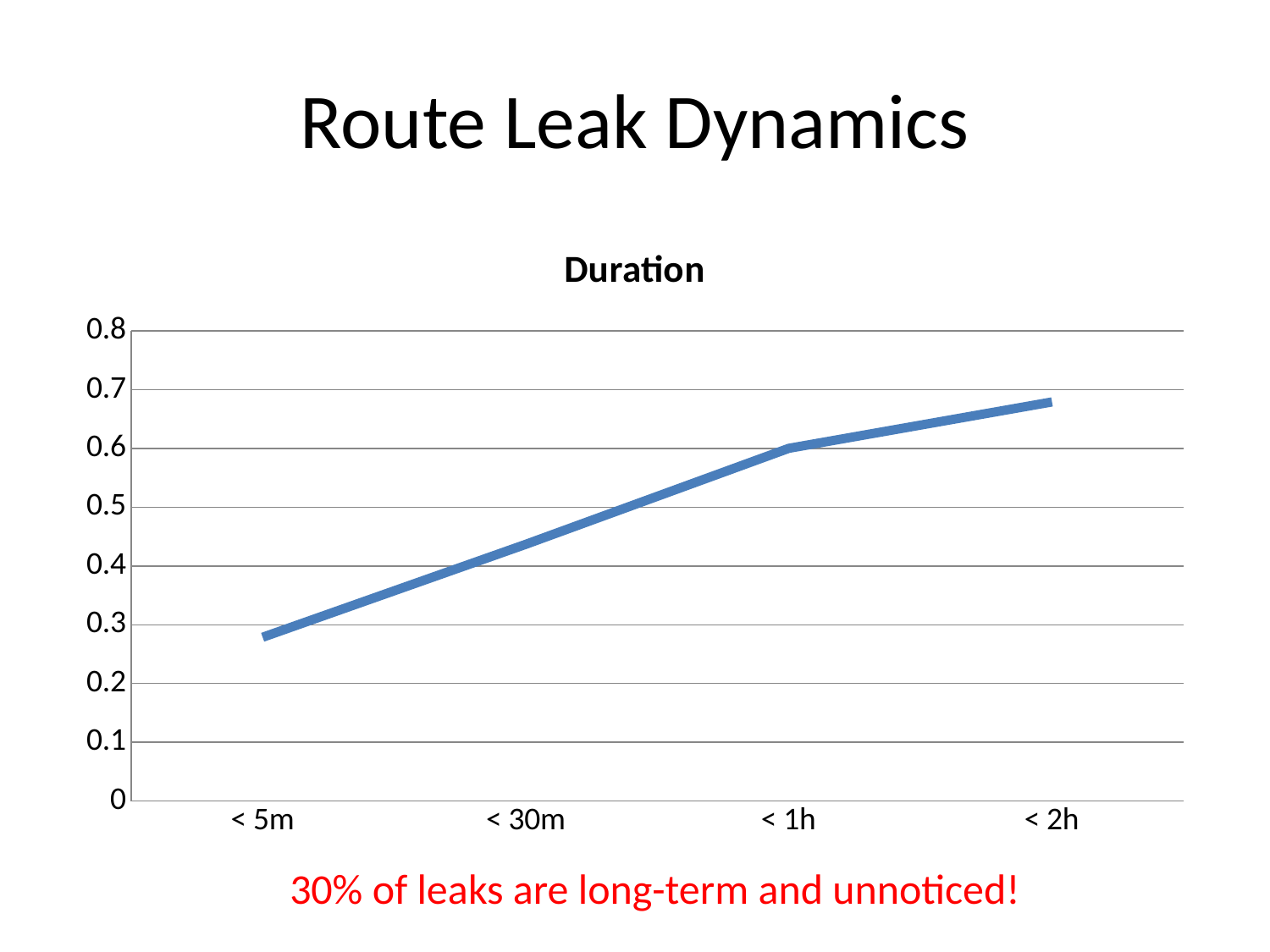
Which is larger, the value for < 30m or the value for < 1h? < 1h Do the values rise or fall along the x axis from < 5m to < 2h? rise Which category has the highest value in the chart? < 2h Is the value for < 5m greater or less than 0.3? less Is the value for < 2h greater or less than 0.7? less Which category has the lowest value in the chart? < 5m What kind of chart is shown on the slide? line chart Is the value for < 30m greater or less than 0.4? greater How many categories are shown on the x axis of the chart? 4 What is the value for < 1h in the chart? 0.6 What is the title of the chart? Duration